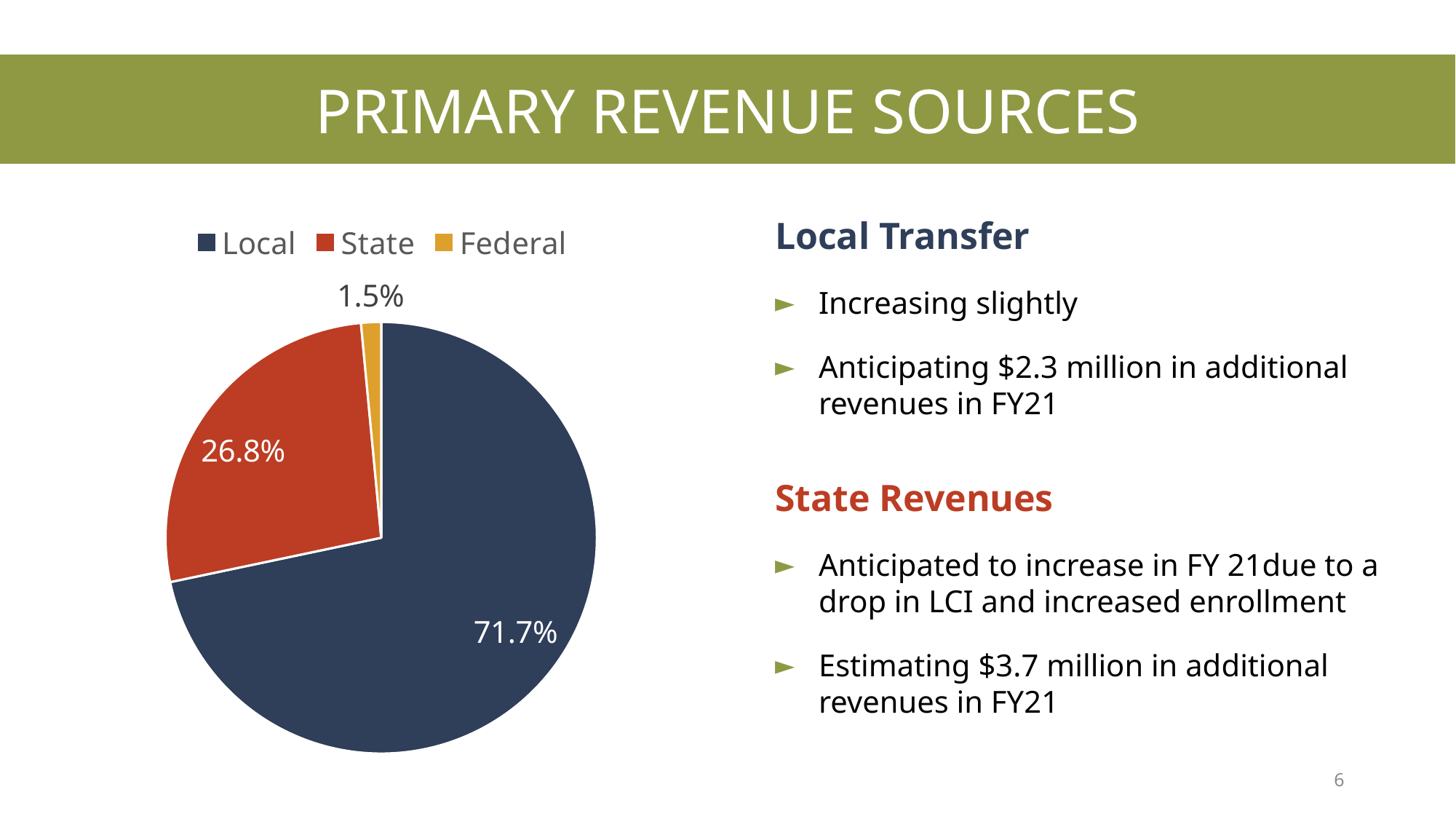
What share of revenue comes from Federal sources? 1.5% What share of revenue comes from State sources? 26.8% How many entries does the legend list? 3 What type of chart is shown on the slide? Pie chart What is the difference in percentage points between the State and Federal shares? 25.3 What share of revenue comes from Local sources? 71.7% Which revenue source has the smallest share of the pie? Federal What colour represents the State slice in the pie chart? Red How many revenue sources are shown in the pie chart? 3 Which is larger, the State share or the Federal share? State What is the difference in percentage points between the Local and State shares? 44.9 Which revenue source has the largest share of the pie? Local